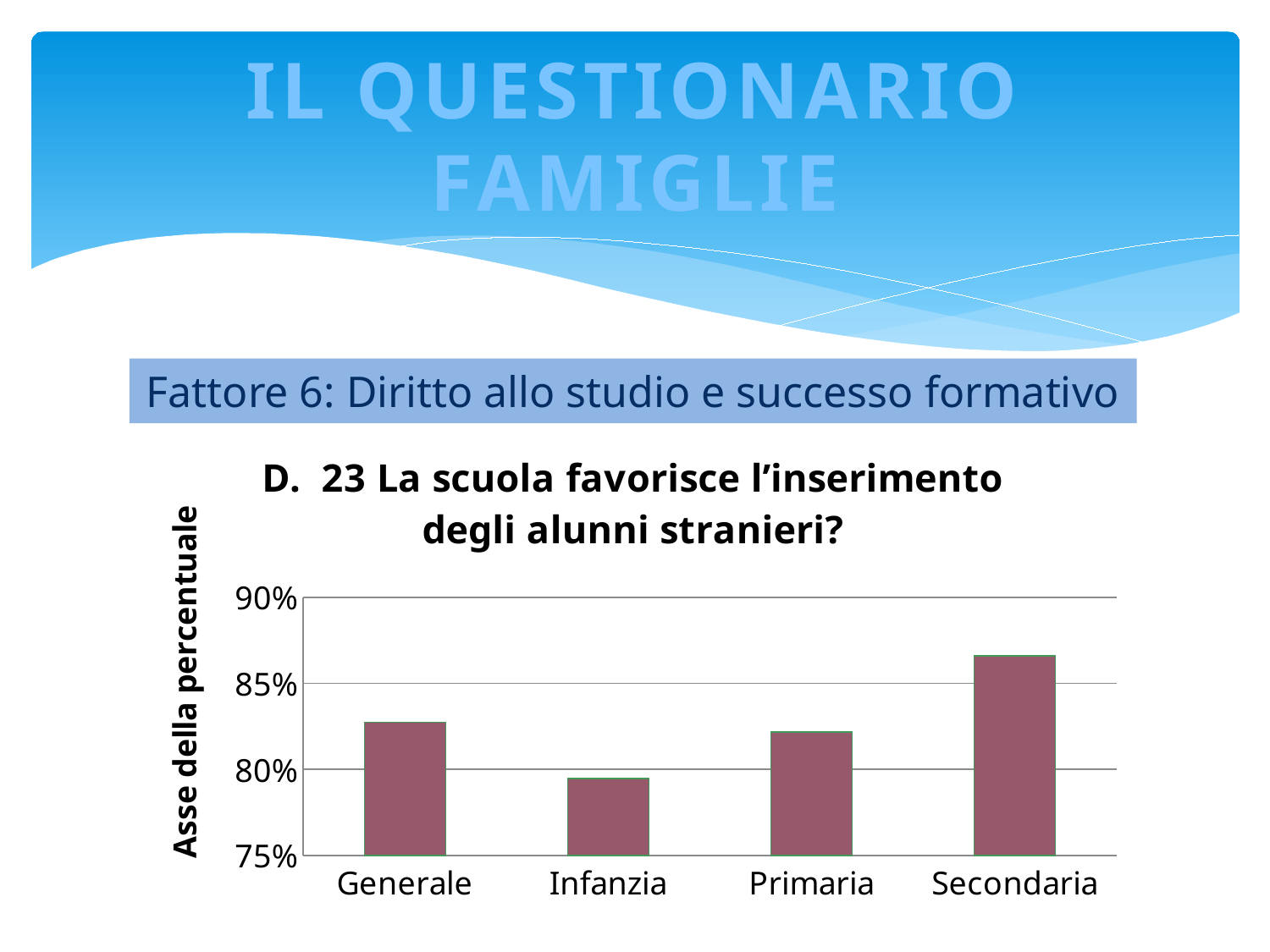
Is the value for Secondaria greater or less than 85%? greater How many categories are shown on the x axis of the chart? 4 Is the value for Primaria greater or less than 85%? less Which category has the lowest value in the chart? Infanzia Is the value for Generale greater or less than 80%? greater What is the label of the vertical axis of the chart? Asse della percentuale Which is larger, the value for Generale or the value for Infanzia? Generale What kind of chart is shown on the slide? bar chart What is the title of the chart? D. 23 La scuola favorisce l'inserimento degli alunni stranieri? Which category has the highest value in the chart? Secondaria Which is larger, the value for Secondaria or the value for Infanzia? Secondaria